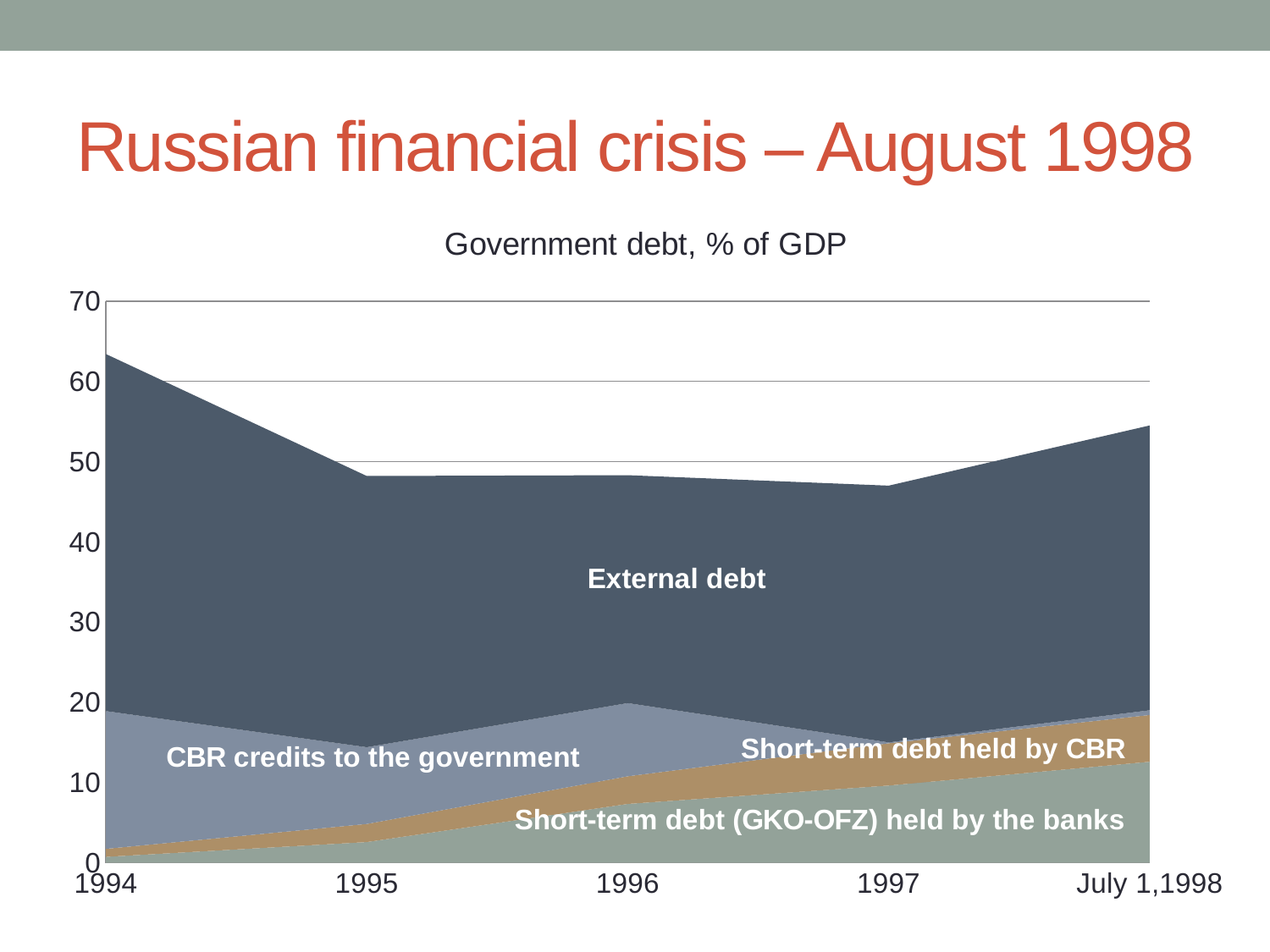
Is the total government debt in 1997 greater or less than 50? less In which year is total government debt as % of GDP highest? 1994 How many time points are shown along the x axis of the chart? 5 Does total government debt rise or fall from 1994 to 1995? fall Is the total government debt on July 1, 1998 greater or less than 50? greater How many debt components (series) are labelled in the chart? 4 Is the total government debt in 1995 greater or less than 50? less What is the title of the chart? Government debt, % of GDP What kind of chart is shown on the slide? Area chart Which series occupies the largest area of the chart? External debt Which is larger: total government debt in 1994 or on July 1, 1998? 1994